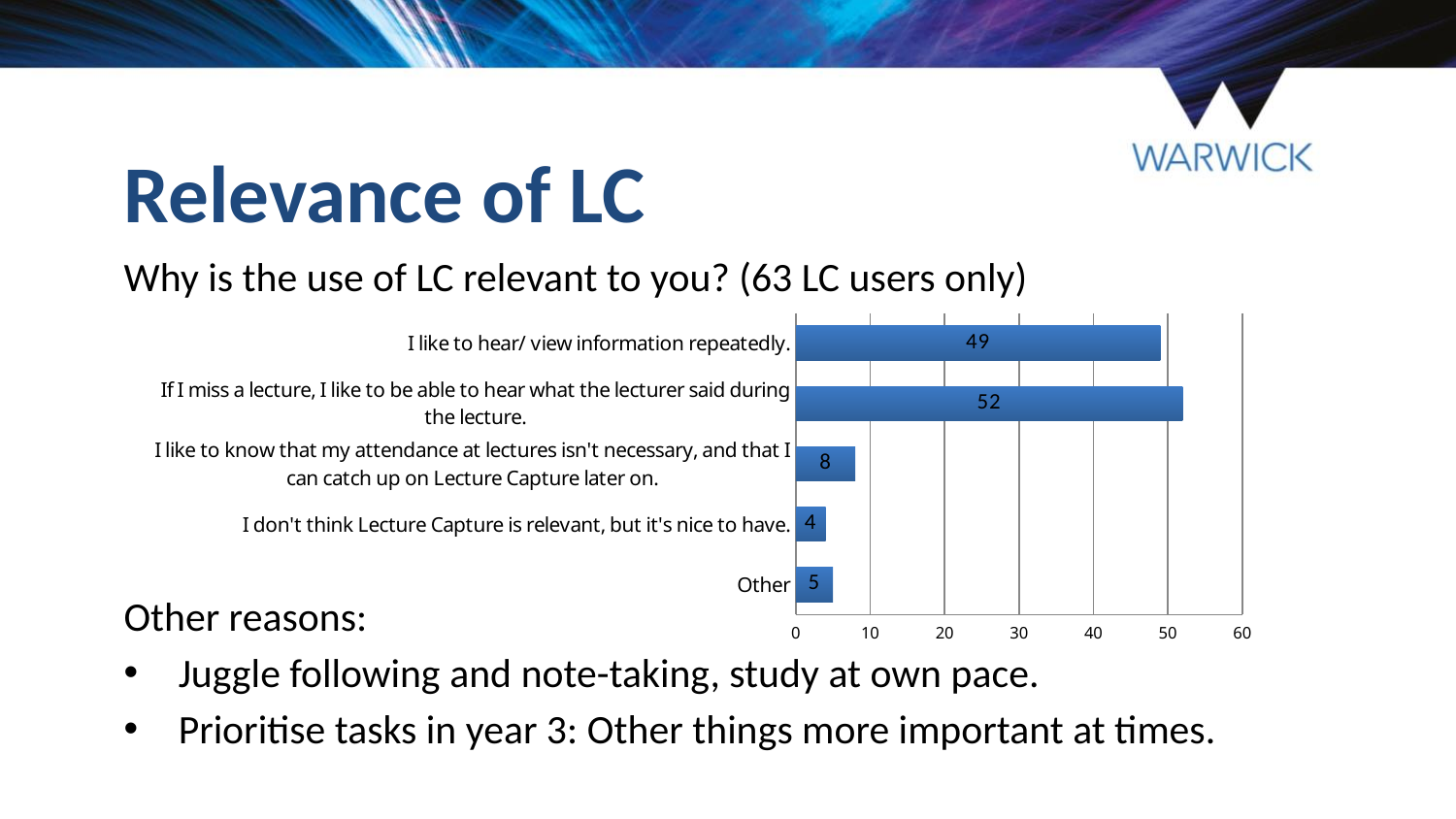
Which category has the highest value? If I miss a lecture, I like to be able to hear what the lecturer said during the lecture. What value is shown for "If I miss a lecture, I like to be able to hear what the lecturer said during the lecture."? 52 What value is shown for "Other"? 5 Is the value for "I like to hear/ view information repeatedly." greater or less than 40? greater Which category has the lowest value? I don't think Lecture Capture is relevant, but it's nice to have. What kind of chart is shown on the slide? bar chart What is the difference between the values for "If I miss a lecture, I like to be able to hear what the lecturer said during the lecture." and "I like to hear/ view information repeatedly."? 3 What value is shown for "I don't think Lecture Capture is relevant, but it's nice to have."? 4 Which is larger: the value for "I like to know that my attendance at lectures isn't necessary, and that I can catch up on Lecture Capture later on." or the value for "Other"? I like to know that my attendance at lectures isn't necessary, and that I can catch up on Lecture Capture later on. What value is shown for "I like to hear/ view information repeatedly."? 49 What is the maximum value shown on the horizontal axis of the chart? 60 How many categories are shown in the chart? 5